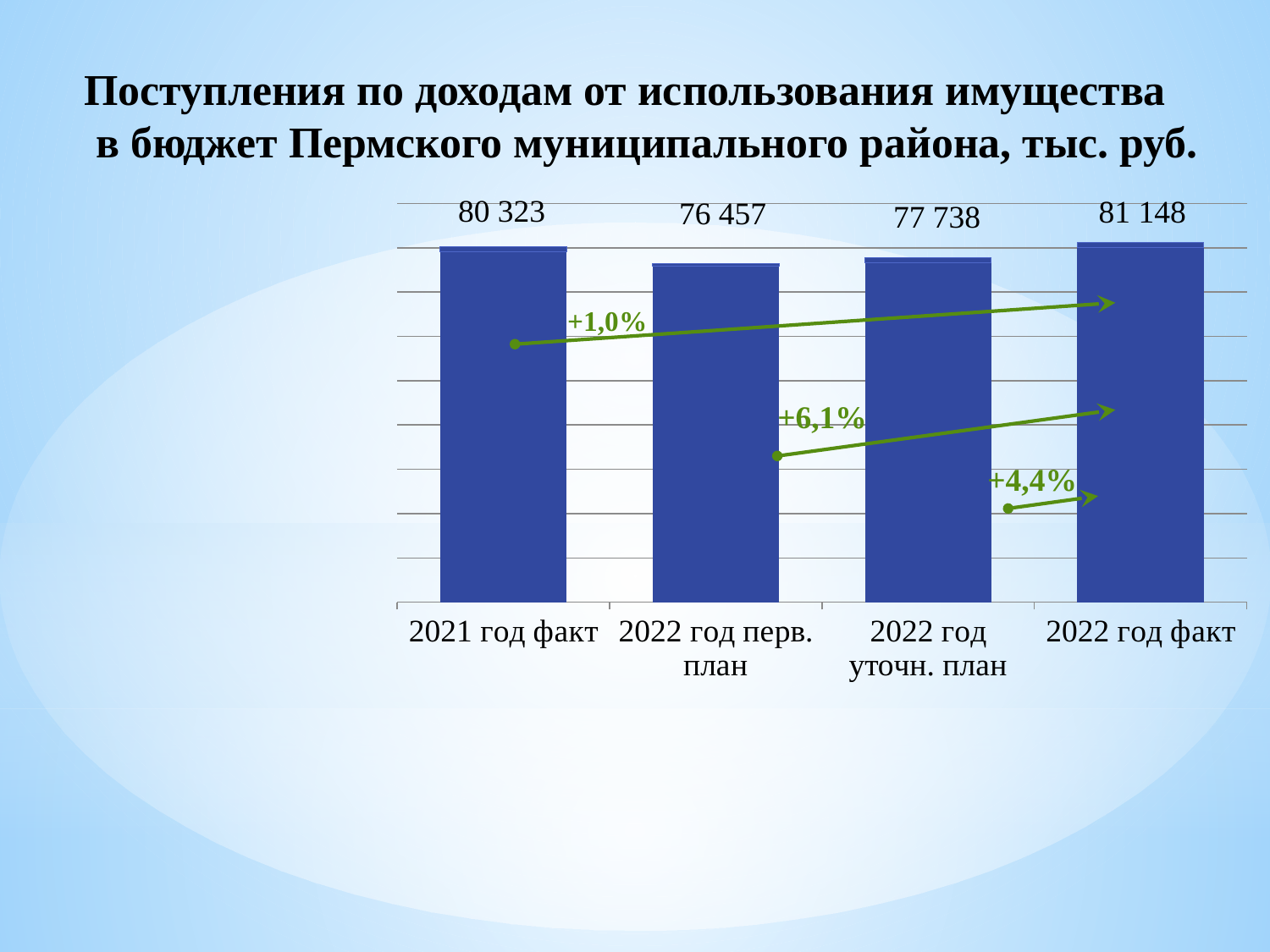
What is the value for "2021 год факт"? 80 323 Which is larger: the value for "2021 год факт" or the value for "2022 год уточн. план"? 2021 год факт Which category has the lowest value? 2022 год перв. план What is the value for "2022 год факт"? 81 148 Which category has the highest value? 2022 год факт What is the value for "2022 год уточн. план"? 77 738 What kind of chart is shown on the slide? bar chart How many categories are shown on the x axis? 4 What is the value for "2022 год перв. план"? 76 457 What is the difference between the values for "2022 год уточн. план" and "2022 год перв. план"? 1 281 What is the difference between the values for "2022 год факт" and "2022 год перв. план"? 4 691 What percentage change is annotated between "2022 год перв. план" and "2022 год факт"? +6,1%